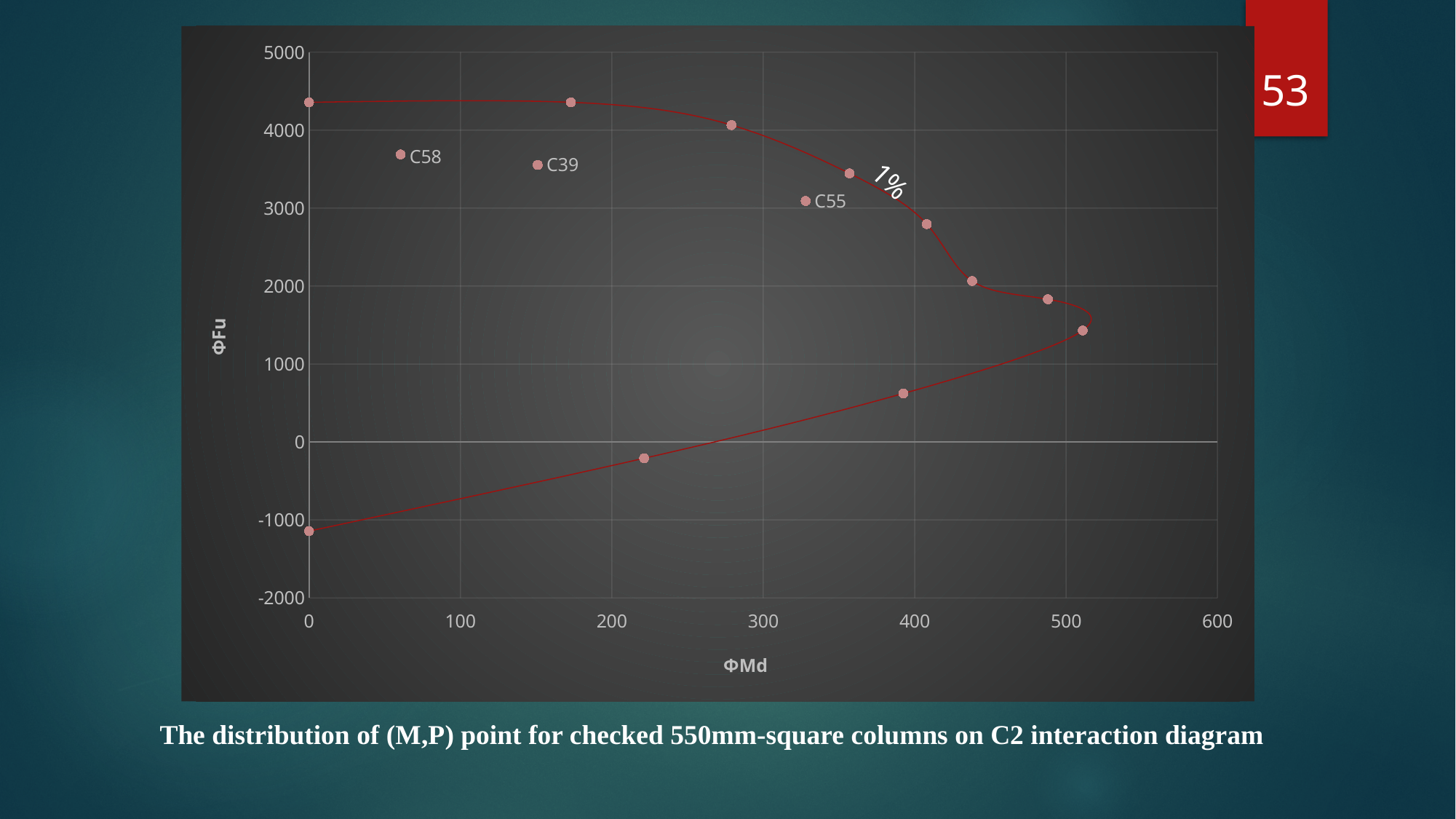
Is the ΦMd value for point C58 greater or less than 100? less What is the title of the horizontal axis? ΦMd Which labeled point has the larger ΦMd value, C39 or C55? C55 What kind of chart is shown on the slide? scatter chart What is the title of the vertical axis? ΦFu Is the ΦFu value for point C58 greater or less than 3000? greater How many labeled column points (C-labels) are plotted on the chart? 3 Which labeled point has the higher ΦFu value, C58 or C55? C58 Is the ΦFu value for point C55 greater or less than 4000? less Among the labeled points C58, C39 and C55, which has the largest ΦMd value? C55